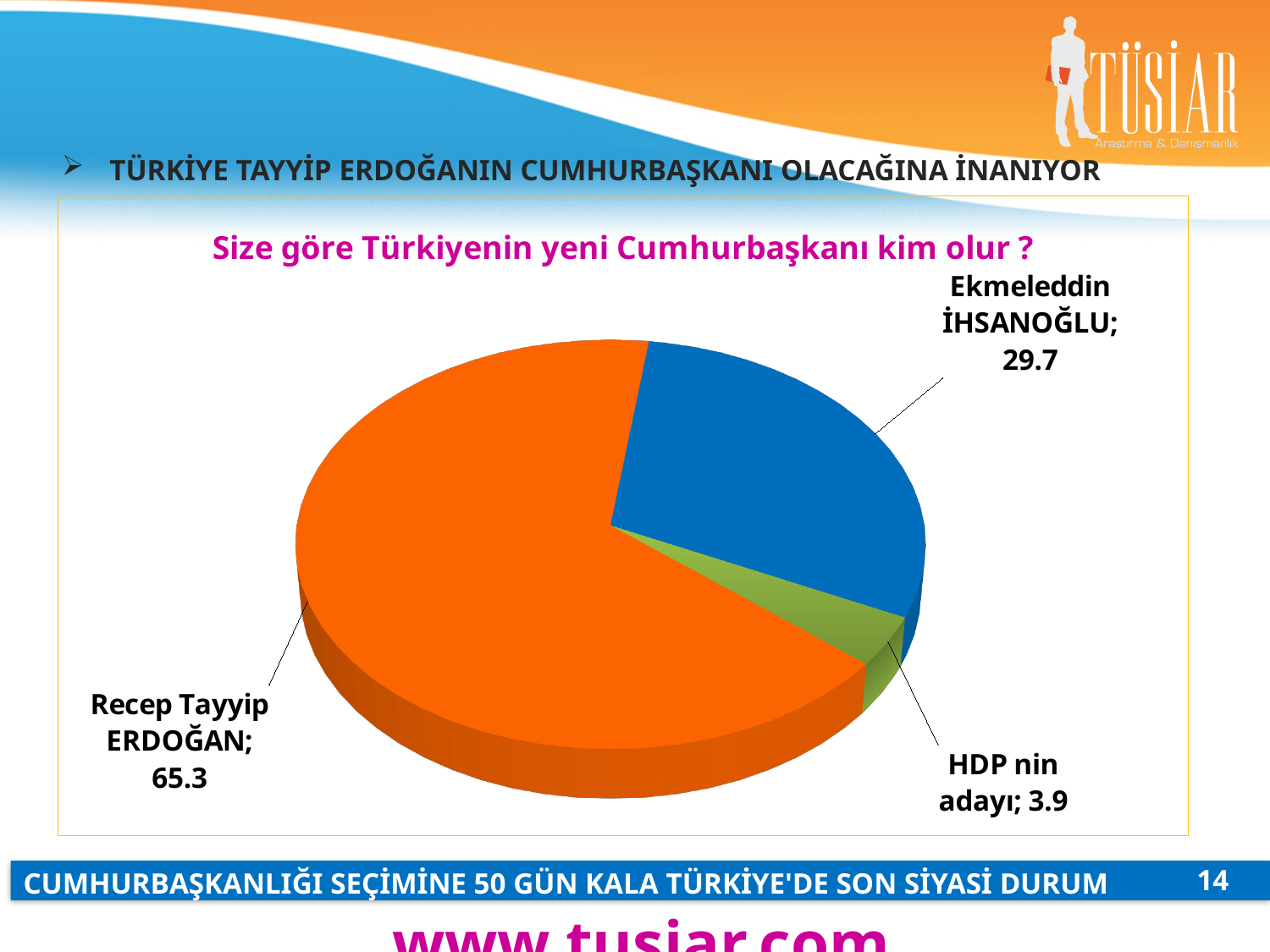
What colour is the slice for Recep Tayyip ERDOĞAN? Orange What is the value for Recep Tayyip ERDOĞAN? 65.3 What kind of chart is shown on the slide? Pie chart What is the value for Ekmeleddin İHSANOĞLU? 29.7 How many slices does the pie chart have? 3 What is the value for HDP nin adayı? 3.9 Which category has the largest slice? Recep Tayyip ERDOĞAN What is the title of the chart? Size göre Türkiyenin yeni Cumhurbaşkanı kim olur ? Which is larger, the value for Ekmeleddin İHSANOĞLU or the value for HDP nin adayı? Ekmeleddin İHSANOĞLU What is the difference between the values for Ekmeleddin İHSANOĞLU and HDP nin adayı? 25.8 Which category has the smallest slice? HDP nin adayı What is the difference between the values for Recep Tayyip ERDOĞAN and Ekmeleddin İHSANOĞLU? 35.6